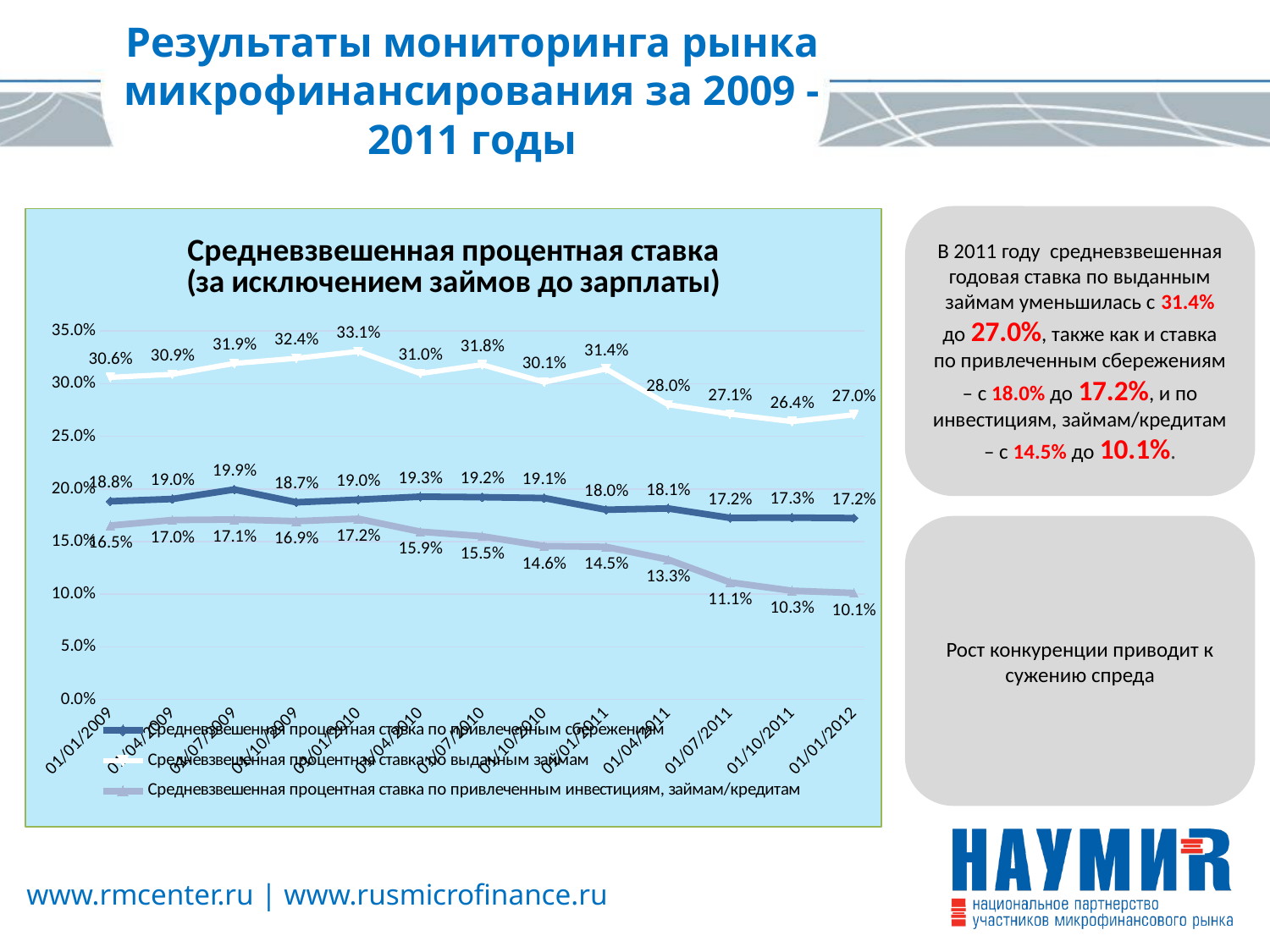
What is the difference between the rate on issued loans on 01/01/2009 (30.6%) and on 01/01/2012 (27.0%)? 3.6% What type of chart is shown on the slide? line chart What is the value of the weighted average rate on attracted investments, loans/credits (по привлеченным инвестициям, займам/кредитам) on 01/01/2012? 10.1% How many dates are plotted along the x axis of the chart? 13 Which is larger on 01/10/2011: the rate on attracted savings or the rate on attracted investments, loans/credits? the rate on attracted savings On which date is the weighted average rate on issued loans at its highest? 01/01/2010 What is the value of the weighted average rate on issued loans (Средневзвешенная процентная ставка по выданным займам) on 01/01/2010? 33.1% On which date is the weighted average rate on attracted investments, loans/credits at its lowest? 01/01/2012 How many series does the chart legend list? 3 What is the value of the weighted average rate on attracted savings (по привлеченным сбережениям) on 01/07/2009? 19.9% Does the weighted average rate on attracted investments, loans/credits rise or fall from 01/01/2010 to 01/01/2012? fall What is the title of the chart? Средневзвешенная процентная ставка (за исключением займов до зарплаты)